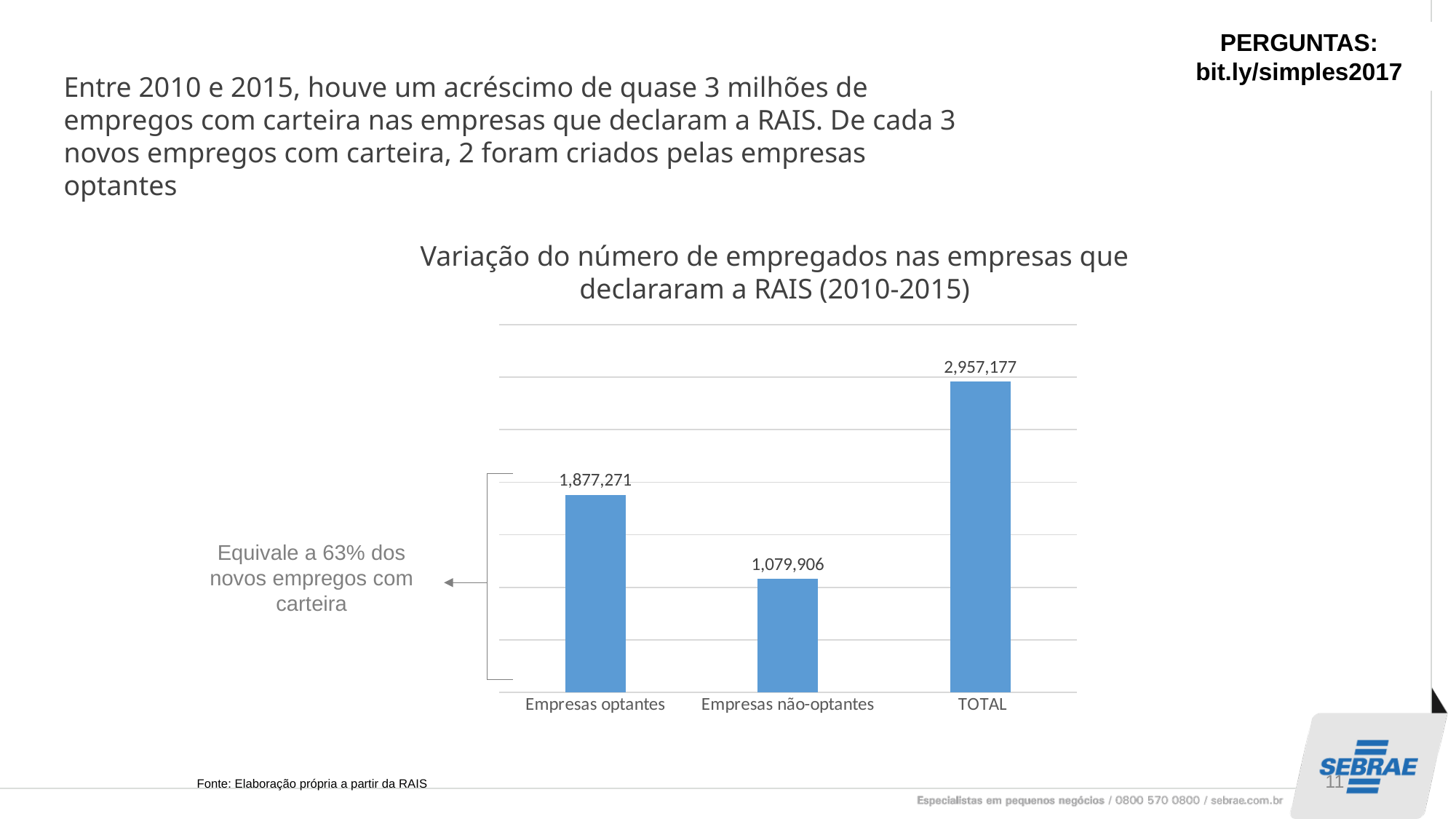
What is the value for Empresas não-optantes? 1,079,906 Which is larger, the value for Empresas optantes or the value for Empresas não-optantes? Empresas optantes How many categories are shown on the x axis? 3 What is the value for TOTAL? 2,957,177 Which category has the highest value? TOTAL What is the value for Empresas optantes? 1,877,271 According to the annotation next to the chart, what share of new formal jobs does the Empresas optantes bar represent? 63% What is the title of the chart? Variação do número de empregados nas empresas que declararam a RAIS (2010-2015) Which category has the lowest value? Empresas não-optantes What kind of chart is shown on the slide? Bar chart What is the difference between the values for Empresas optantes and Empresas não-optantes? 797,365